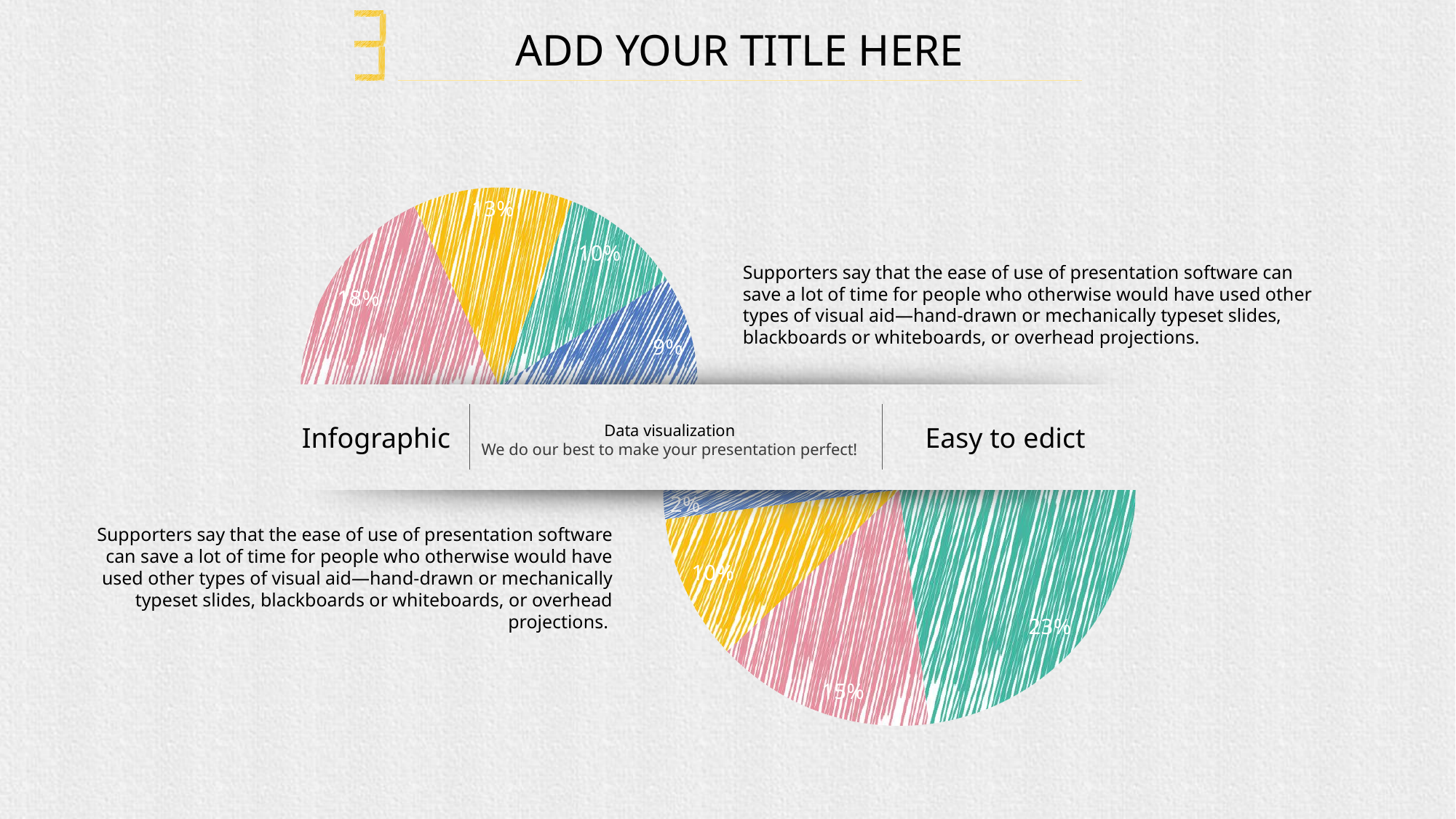
What kind of chart is the bottom chart on the slide? pie chart What kind of chart is the top chart on the slide? pie chart In the bottom pie chart, which colour slice has the smallest labelled value? blue In the top pie chart, what value is labelled on the blue slice? 9% In the top pie chart, which colour slice has the largest labelled value? pink In the bottom pie chart, what value is labelled on the blue slice? 2% In the top pie chart, what value is labelled on the pink slice? 18% In the bottom pie chart, which is larger: the yellow slice or the pink slice? pink slice In the top pie chart, what is the difference between the pink slice's value and the blue slice's value? 9 percentage points In the bottom pie chart, what value is labelled on the green slice? 23% In the top pie chart, what value is labelled on the yellow slice? 13% In the bottom pie chart, what value is labelled on the pink slice? 15%